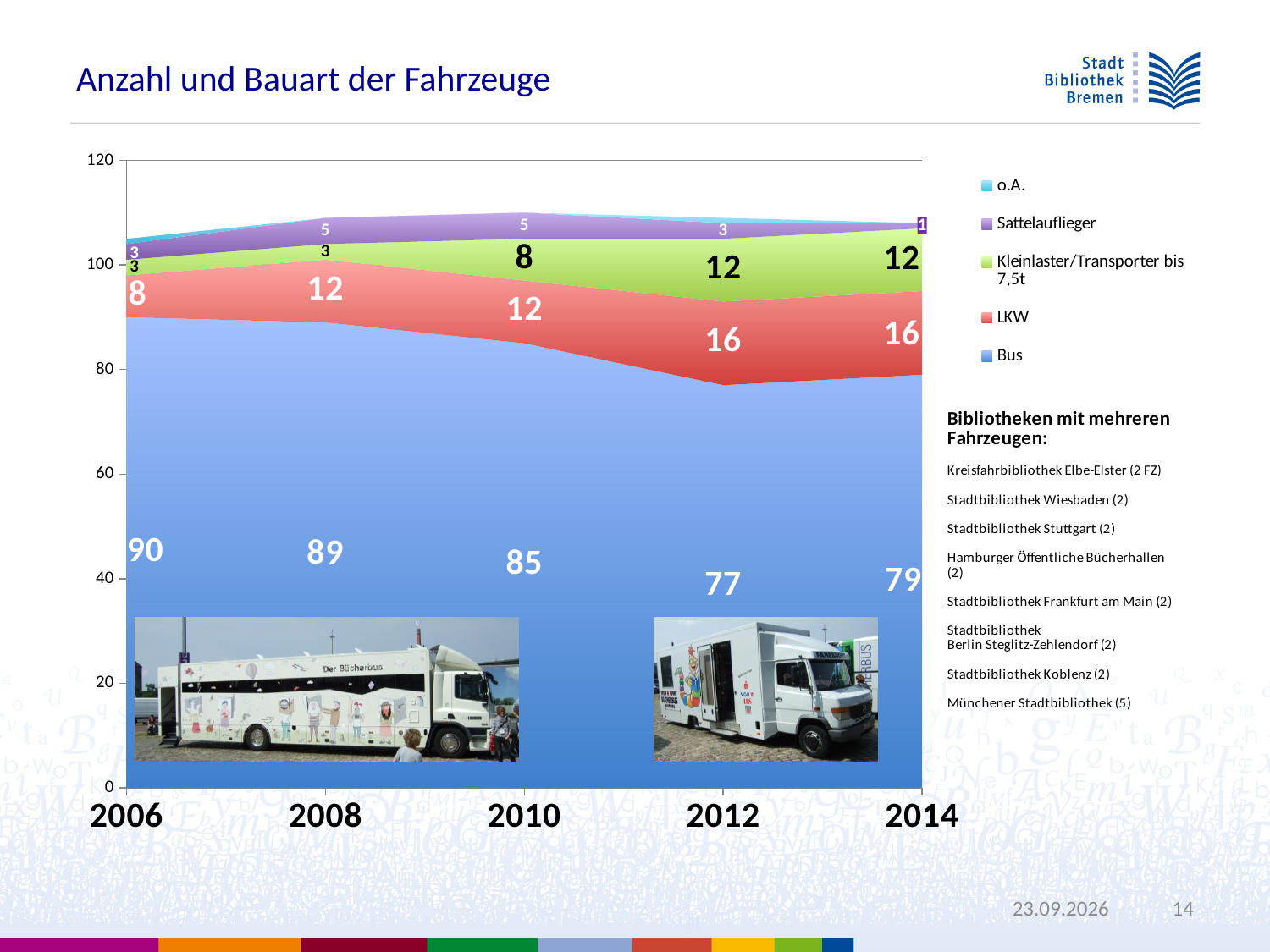
What is the value for LKW in 2012? 16 In which year is the Bus value lowest? 2012 What is the value for Kleinlaster/Transporter bis 7,5t in 2010? 8 In which year is the Bus value highest? 2006 What is the value for Sattelauflieger in 2008? 5 What is the difference between the Bus value in 2006 and in 2014? 11 Which is larger, the LKW value in 2008 or the LKW value in 2014? 2014 How many years are shown on the x axis? 5 What type of chart is shown on the slide? stacked area chart How many series does the legend list? 5 What is the value for Bus in 2006? 90 What is the title of the chart? Anzahl und Bauart der Fahrzeuge